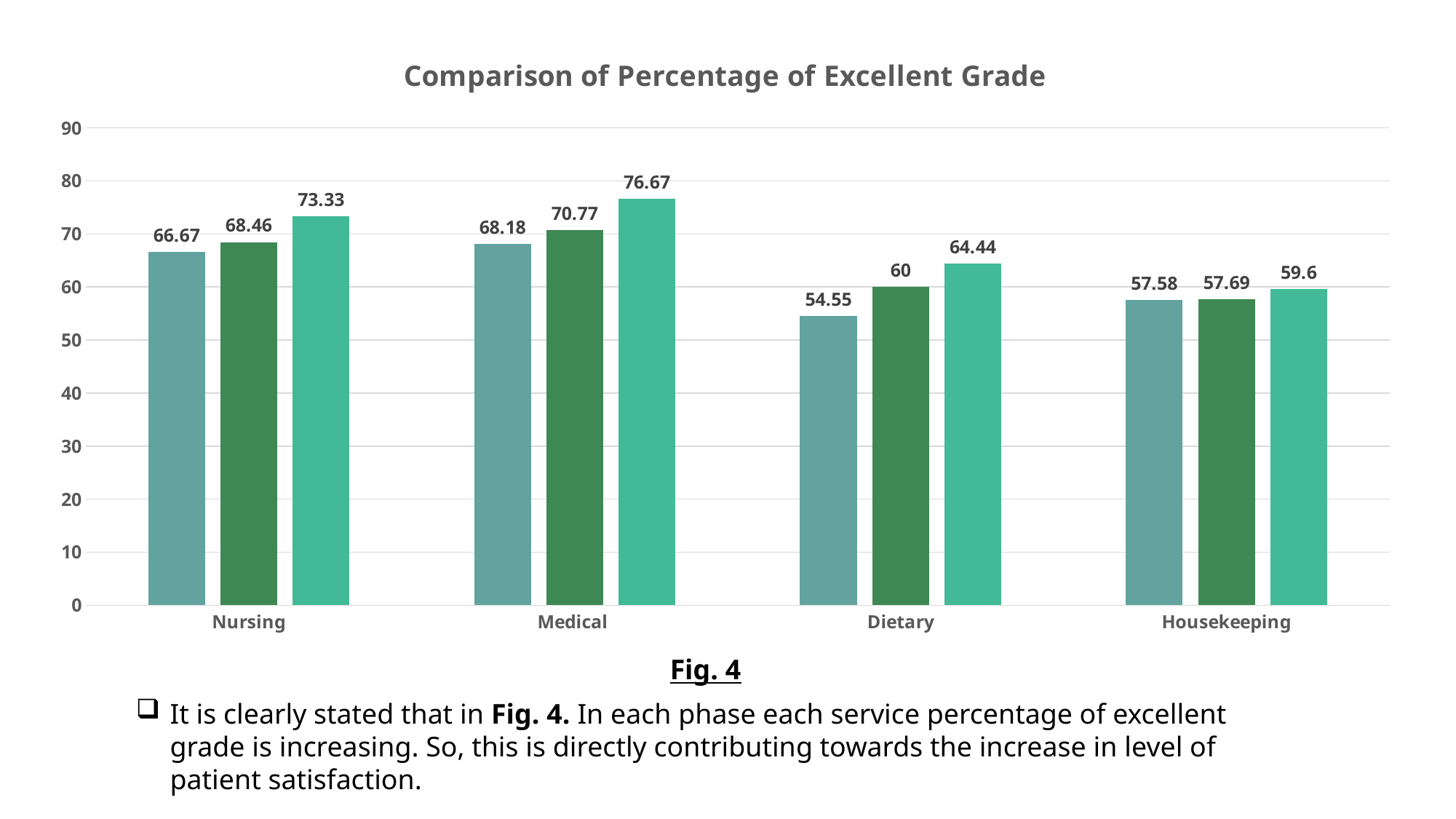
Which category contains the highest bar in the chart? Medical What is the difference between the third bar and the first bar for Nursing? 6.66 What is the value of the first (leftmost) bar for Dietary? 54.55 What is the value of the second (middle) bar for Housekeeping? 57.69 What kind of chart is shown on the slide? bar chart Within each category, do the bar values rise or fall from left to right? rise What is the lowest value shown in the chart? 54.55 Which is larger: the middle bar for Dietary or the middle bar for Housekeeping? Dietary Is the value of the first bar for Dietary greater or less than 60? less How many categories are shown on the x axis of the chart? 4 What is the title of the chart? Comparison of Percentage of Excellent Grade What is the value of the third (rightmost) bar for Medical? 76.67